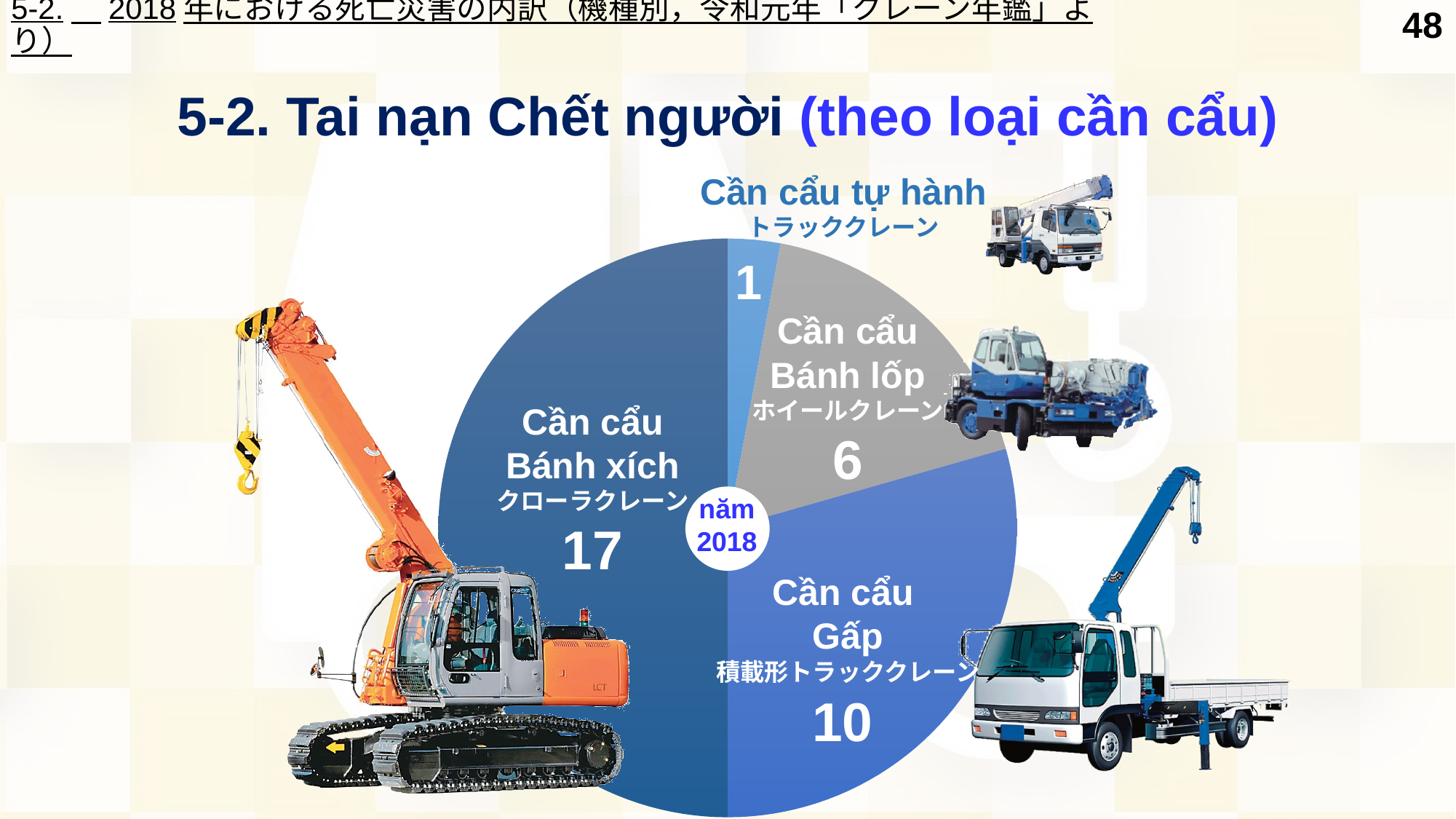
What is the value shown for Cần cẩu Gấp? 10 What is the value shown for Cần cẩu Bánh lốp? 6 Which crane type has the highest number of fatal accidents in the pie chart? Cần cẩu Bánh xích How many fatal accidents are attributed to Cần cẩu Bánh xích (crawler crane)? 17 What is the value shown for Cần cẩu tự hành? 1 What type of chart is shown on the slide? Pie chart Which has a larger value, Cần cẩu Bánh lốp or Cần cẩu Gấp? Cần cẩu Gấp What year is shown in the centre of the pie chart? 2018 What is the total of all values in the pie chart? 34 Which crane type has the lowest number of fatal accidents in the pie chart? Cần cẩu tự hành What is the difference between the values for Cần cẩu Bánh xích and Cần cẩu Gấp? 7 How many slices does the pie chart have? 4